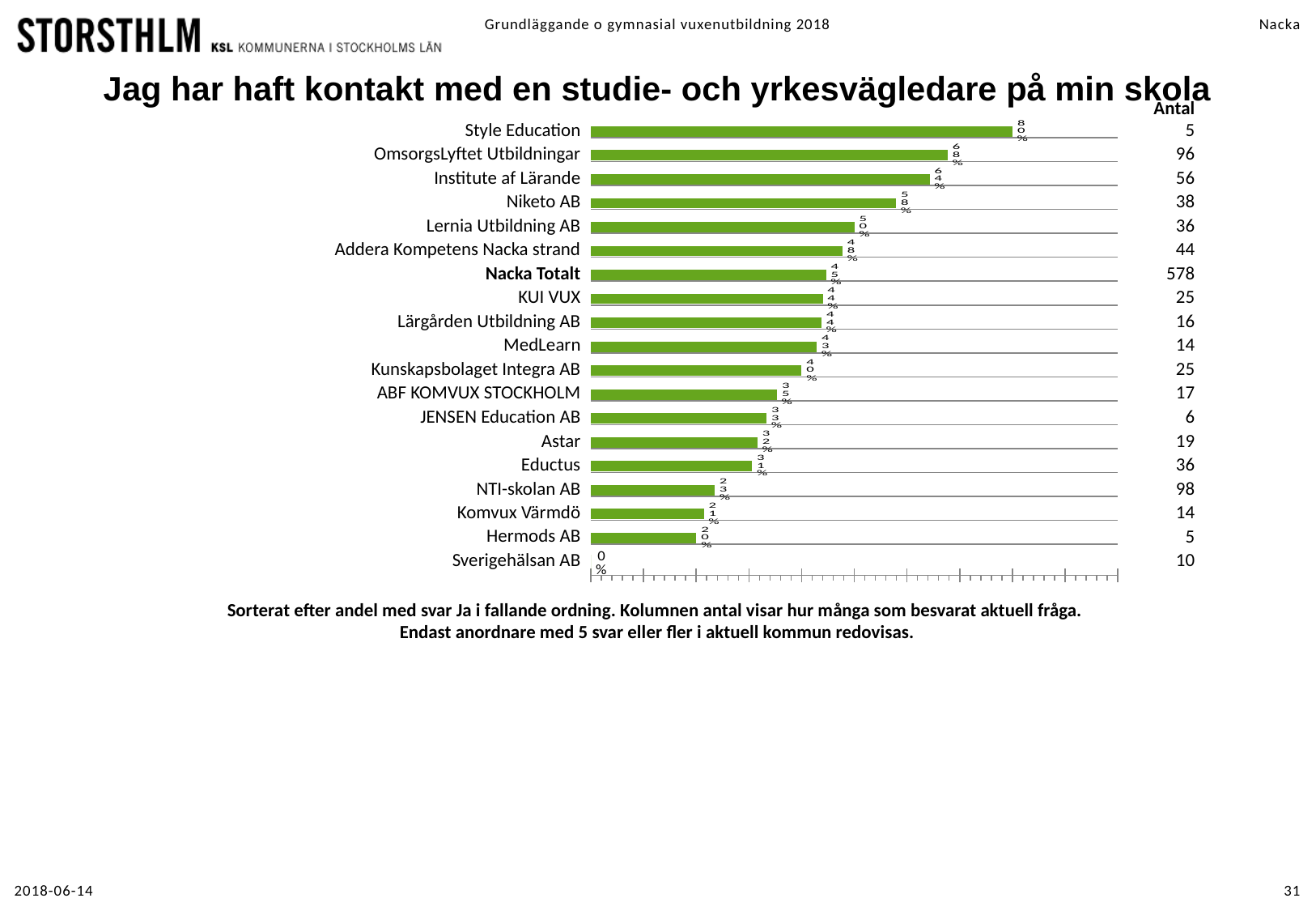
What is the value shown for Niketo AB? 58% What is the title of the chart? Jag har haft kontakt med en studie- och yrkesvägledare på min skola What is the value shown for Style Education? 80% What is the value shown for Nacka Totalt? 45% How many categories (rows) are plotted in the chart? 19 Which has a larger value, Lernia Utbildning AB or Eductus? Lernia Utbildning AB Which category has the lowest value in the chart? Sverigehälsan AB Do the bar values rise or fall going from the top row to the bottom row of the chart? fall What is the difference in percentage points between Style Education and OmsorgsLyftet Utbildningar? 12 What is the value shown for Hermods AB? 20% What kind of chart is shown on the slide? bar chart Which category has the highest value in the chart? Style Education